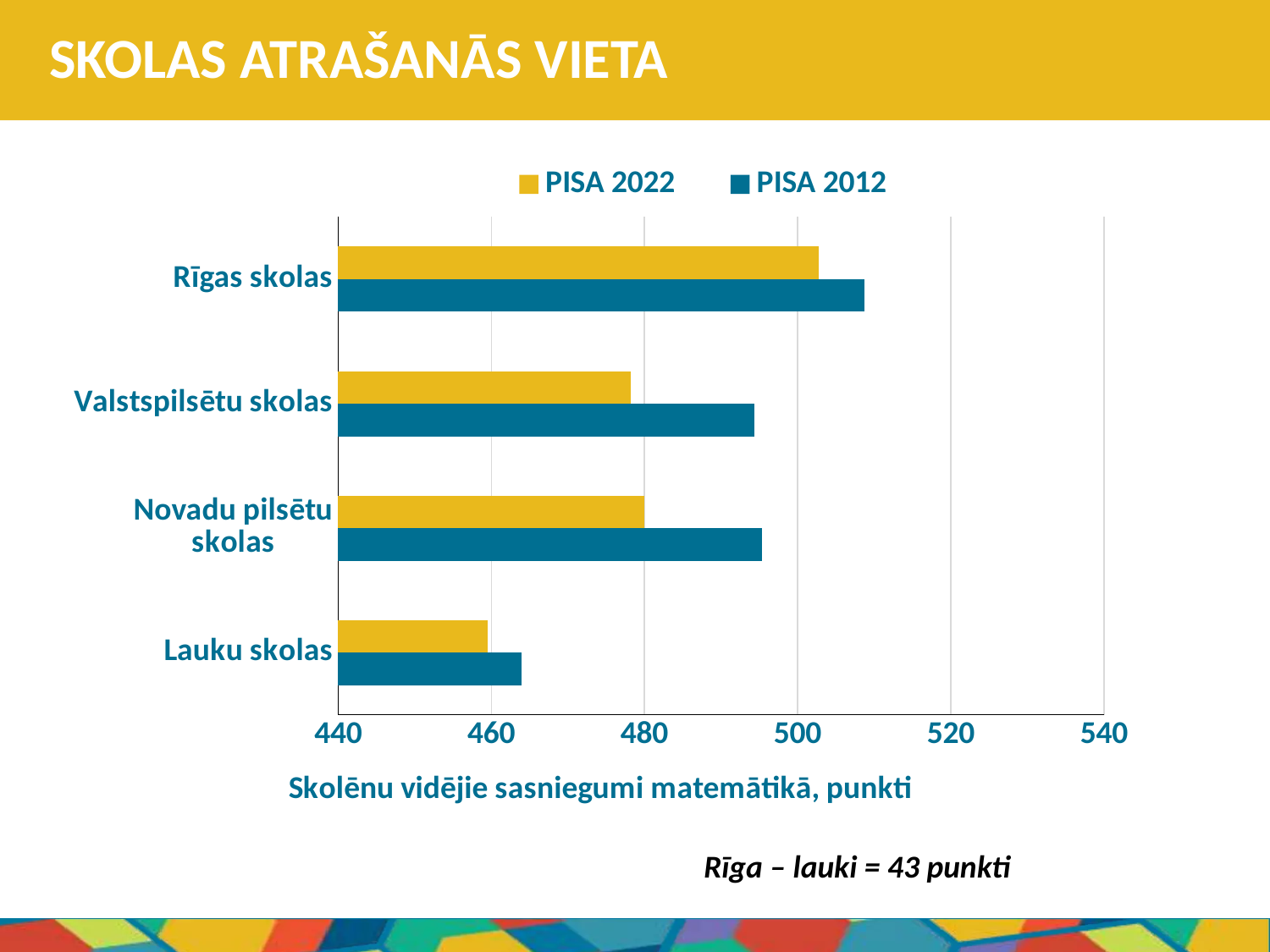
Which category has the lowest PISA 2012 value? Lauku skolas Is the PISA 2012 value for Lauku skolas greater or less than 460? greater Is the PISA 2012 value for Valstspilsētu skolas greater or less than 500? less What kind of chart is shown on the slide? bar chart Is the PISA 2022 value for Valstspilsētu skolas greater or less than 480? less How many school location categories are shown on the chart? 4 For Novadu pilsētu skolas, which is larger: the PISA 2012 value or the PISA 2022 value? PISA 2012 What is the title of the horizontal axis? Skolēnu vidējie sasniegumi matemātikā, punkti How many series does the legend list? 2 Which category has the highest PISA 2022 value? Rīgas skolas Which series is shown in yellow in the legend? PISA 2022